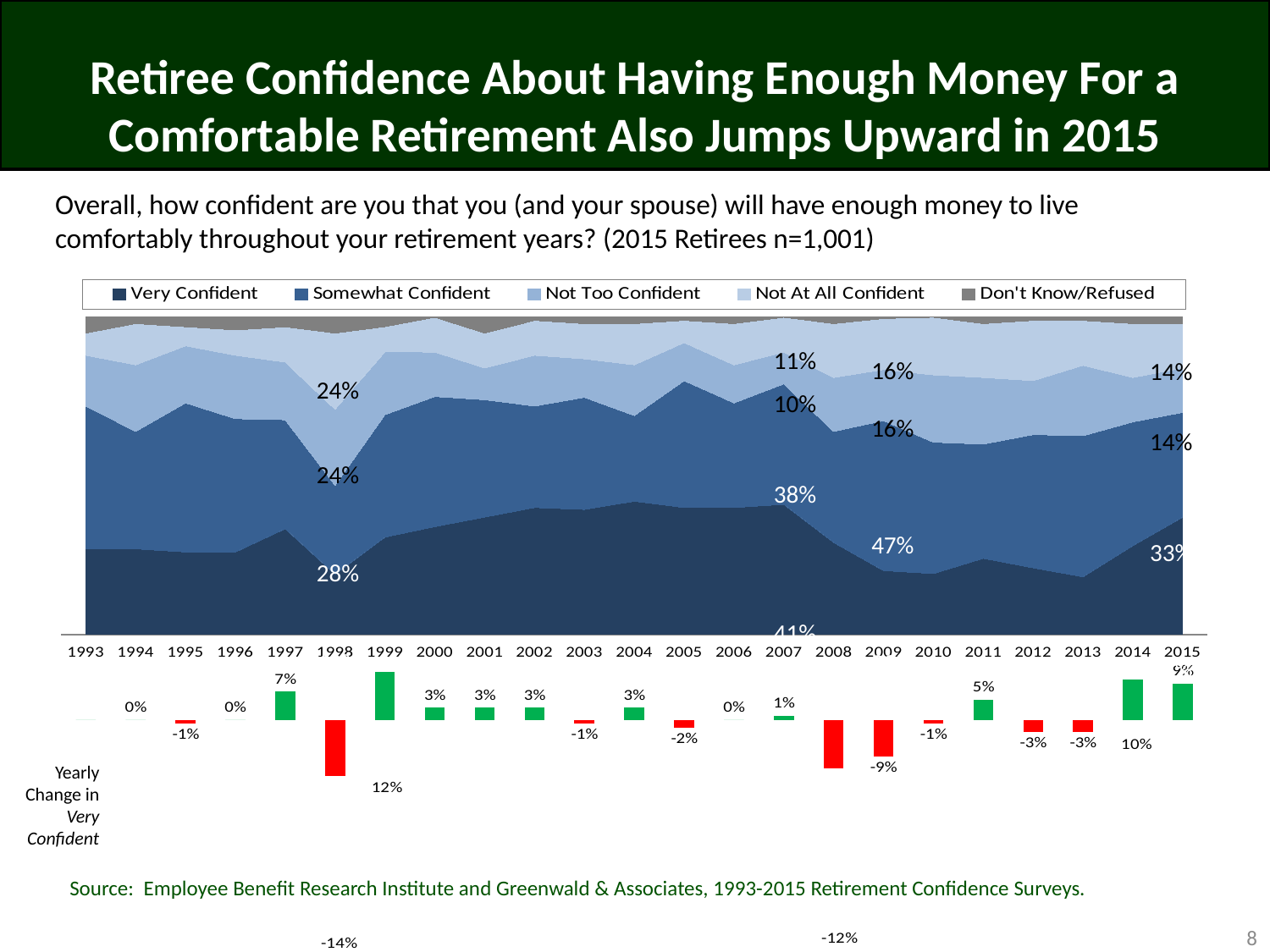
In the top stacked area chart, what is the Somewhat Confident value labeled for 2007? 38% In the bottom chart showing yearly change in Very Confident, what is the value for 1997? 7% In the bottom chart showing yearly change in Very Confident, which year has the largest positive change? 1999 In the bottom chart showing yearly change in Very Confident, what is the value for 2011? 5% In the bottom chart showing yearly change in Very Confident, what is the value for 2009? -9% In the bottom chart showing yearly change in Very Confident, which year has the largest negative change? 1998 What kind of chart is the bottom chart showing yearly change in Very Confident? Bar chart How many series does the legend of the top chart list? 5 In the bottom chart showing yearly change in Very Confident, what is the difference between the 2014 value and the 2011 value? 5% In the bottom chart showing yearly change in Very Confident, is the change for 2014 larger than the change for 2004? Yes